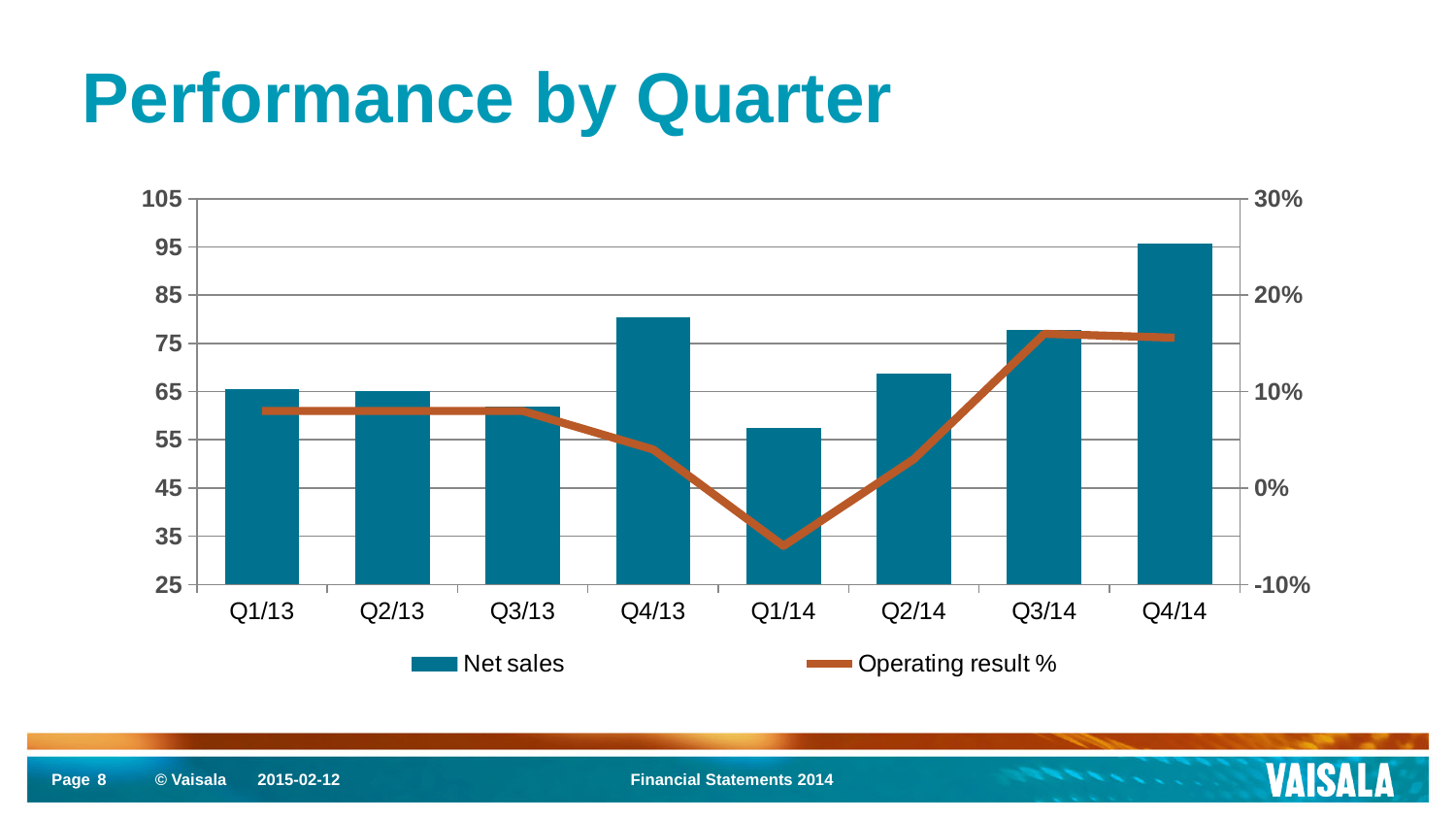
Is the operating result % for Q1/14 greater or less than 0%? less How many series does the legend list? 2 Is the net sales value for Q4/14 greater or less than 85? greater How many quarters are shown on the x axis? 8 Which quarter has the highest net sales bar? Q4/14 Which quarter has higher net sales, Q4/13 or Q2/14? Q4/13 What is the title of the chart on the slide? Performance by Quarter Which quarter has the lowest net sales bar? Q1/14 Is the net sales value for Q1/14 greater or less than 65? less Does the operating result % rise or fall from Q1/14 to Q3/14? rise What kind of chart is shown on the slide? A combined bar and line chart